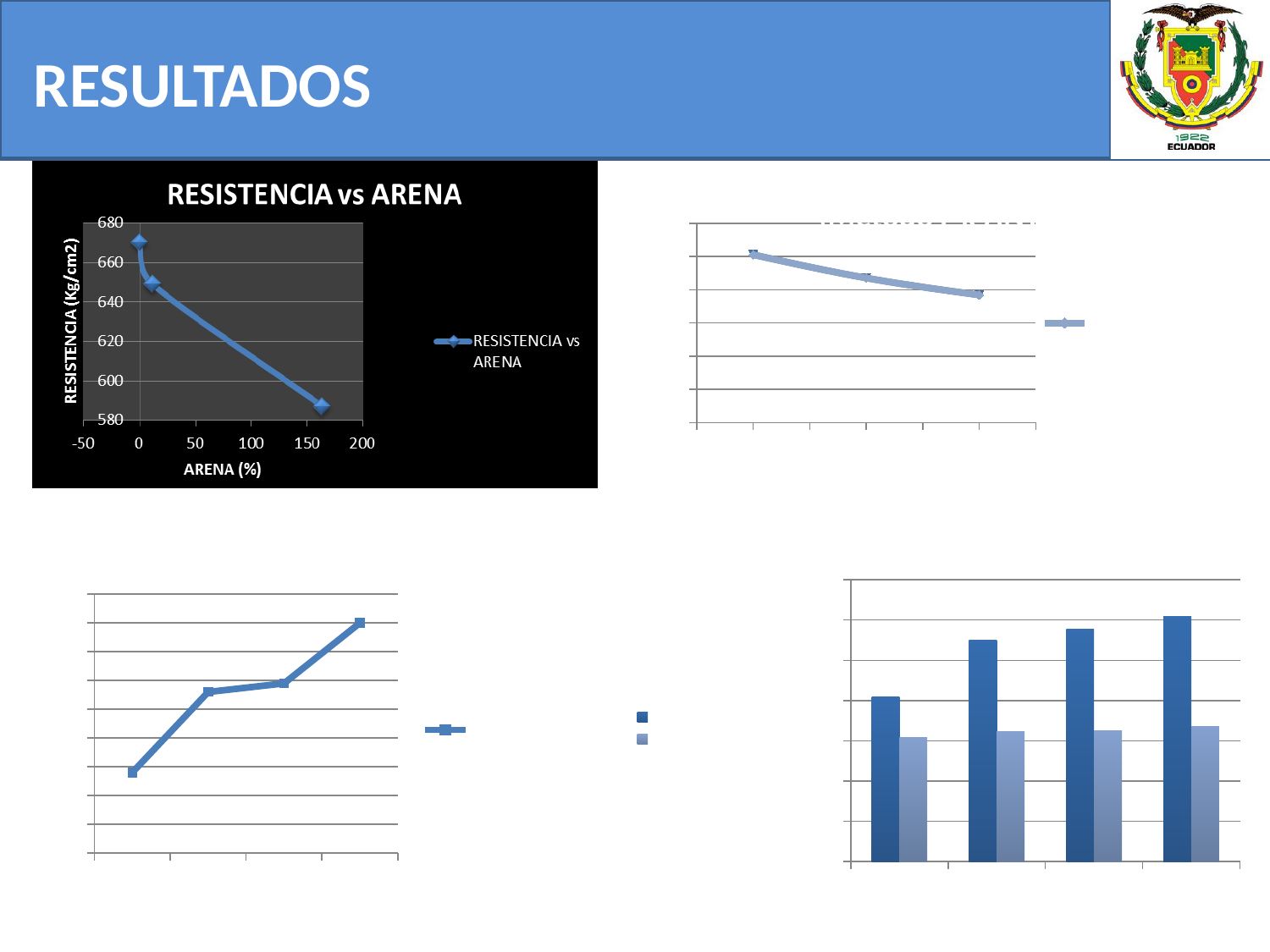
How many series does the legend of the bottom-right chart list? 2 In the top-left chart titled RESISTENCIA vs ARENA, does the resistance rise or fall as ARENA (%) increases? falls In the top-right line chart, do the values rise or fall from left to right along the x axis? fall What is the y-axis label of the top-left chart titled RESISTENCIA vs ARENA? RESISTENCIA (Kg/cm2) What kind of chart is the bottom-right chart on the slide? bar chart How many data points are plotted in the top-left chart titled RESISTENCIA vs ARENA? 3 In the top-left chart titled RESISTENCIA vs ARENA, is the resistance at ARENA 0% greater or less than 660? greater How many series does the legend of the top-left chart titled RESISTENCIA vs ARENA list? 1 In the bottom-left line chart, do the values rise or fall from left to right along the x axis? rise What is the title of the top-left chart? RESISTENCIA vs ARENA What kind of chart is the top-left chart titled RESISTENCIA vs ARENA? line chart In the top-left chart titled RESISTENCIA vs ARENA, is the resistance at the highest ARENA value plotted greater or less than 600? less